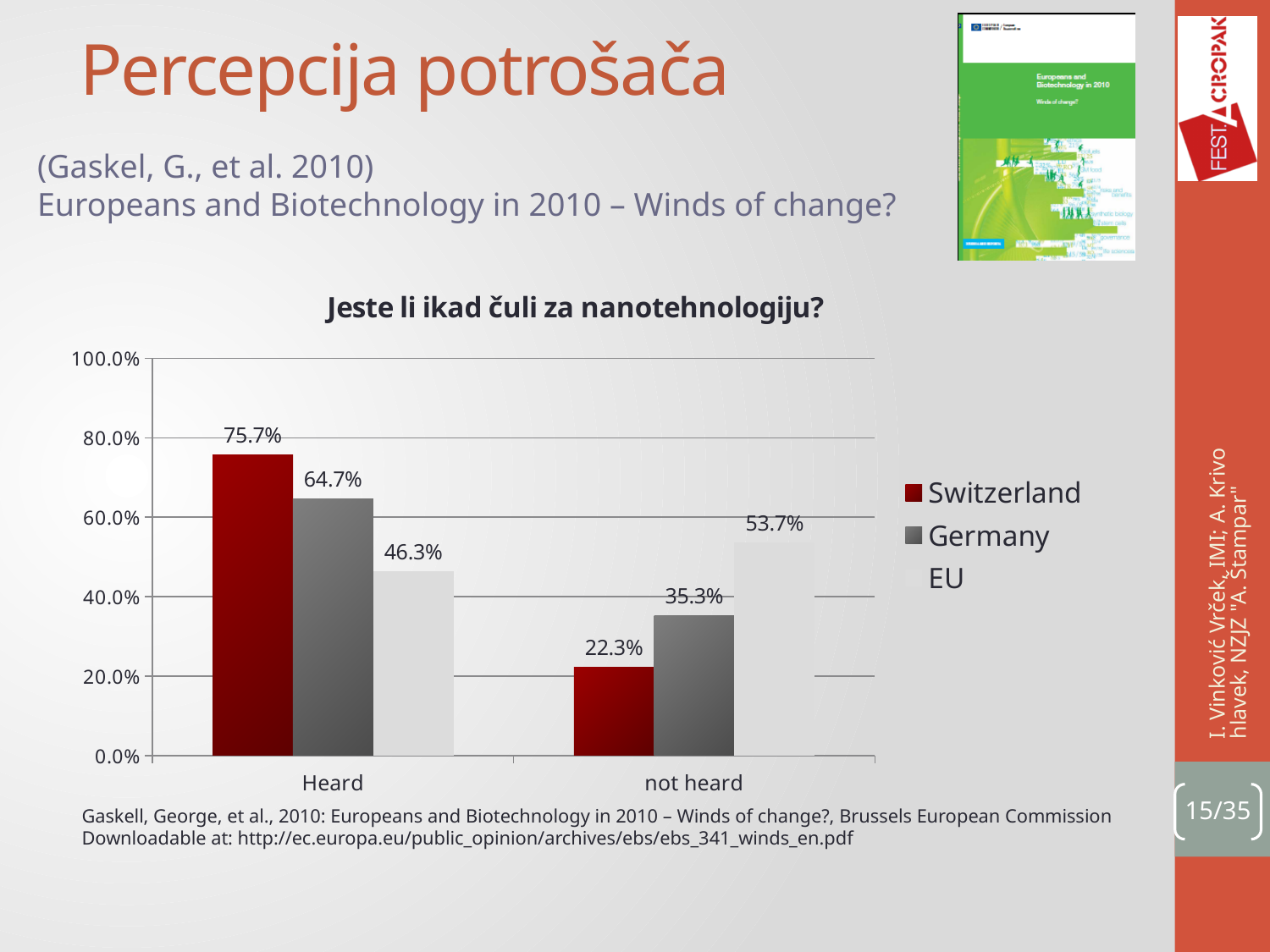
How many series does the legend list? 3 Which series has the highest value in the "Heard" category? Switzerland What is the difference between the Switzerland and EU values in the "Heard" category? 29.4% What is the value for Switzerland in the "Heard" category? 75.7% What is the value for EU in the "not heard" category? 53.7% Which is larger: the Germany value for "Heard" or the Germany value for "not heard"? Heard How many categories are shown on the x axis? 2 What is the value for EU in the "Heard" category? 46.3% What is the value for Germany in the "not heard" category? 35.3% What kind of chart is shown on the slide? Bar chart What is the title of the chart? Jeste li ikad čuli za nanotehnologiju? Which series has the lowest value in the "not heard" category? Switzerland